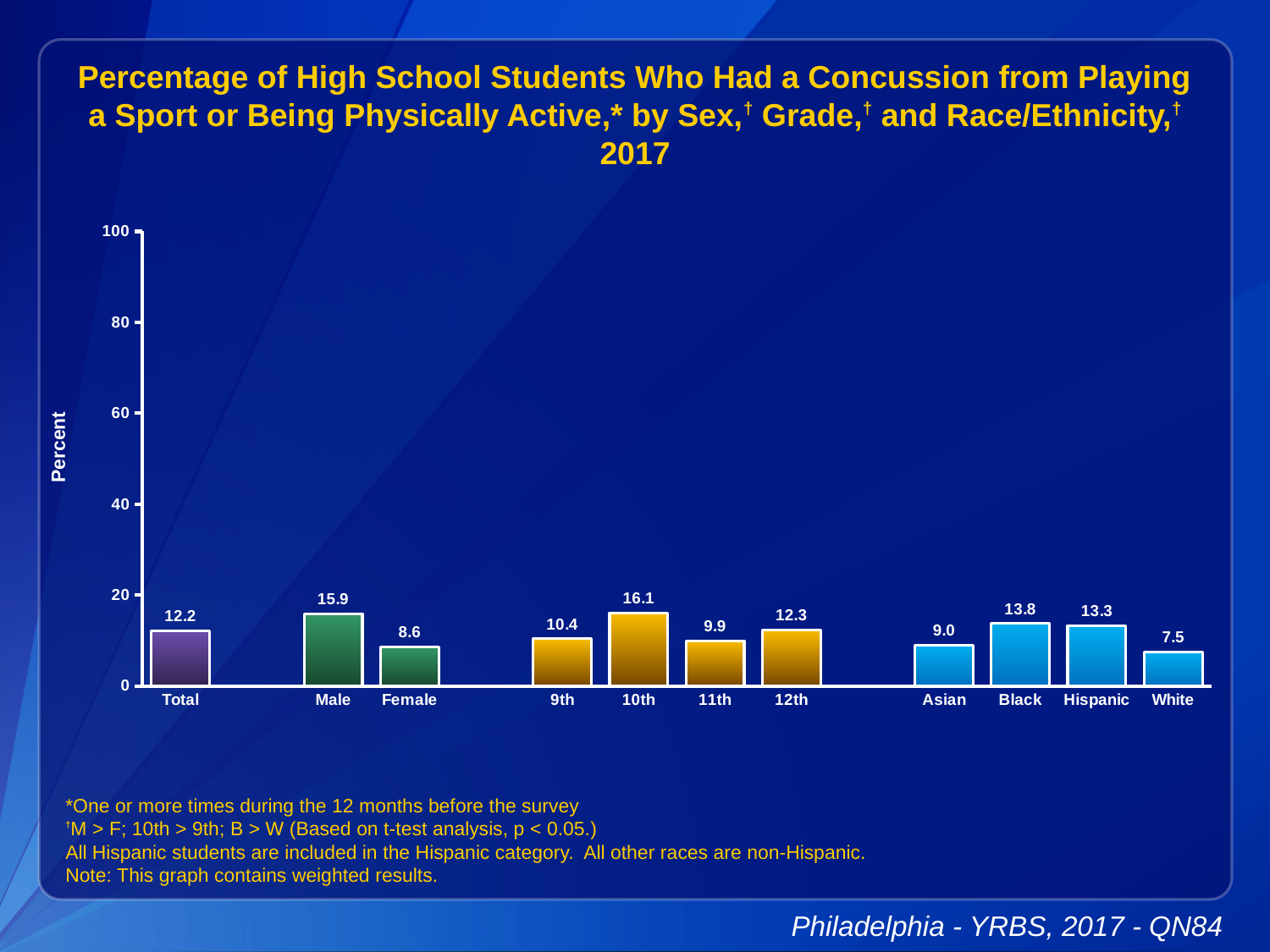
Which category has the lowest value? White Which is larger, the value for Black or the value for White? Black What is the value for Female? 8.6 What is the value for Total? 12.2 What is the difference between the values for Male and Female? 7.3 How many categories are shown on the x axis? 11 What is the value for Hispanic students? 13.3 What is the label of the y axis? Percent What kind of chart is this? Bar chart Is the value for 12th grade greater or less than 20? less Which category has the highest value? 10th What is the value for 11th grade? 9.9